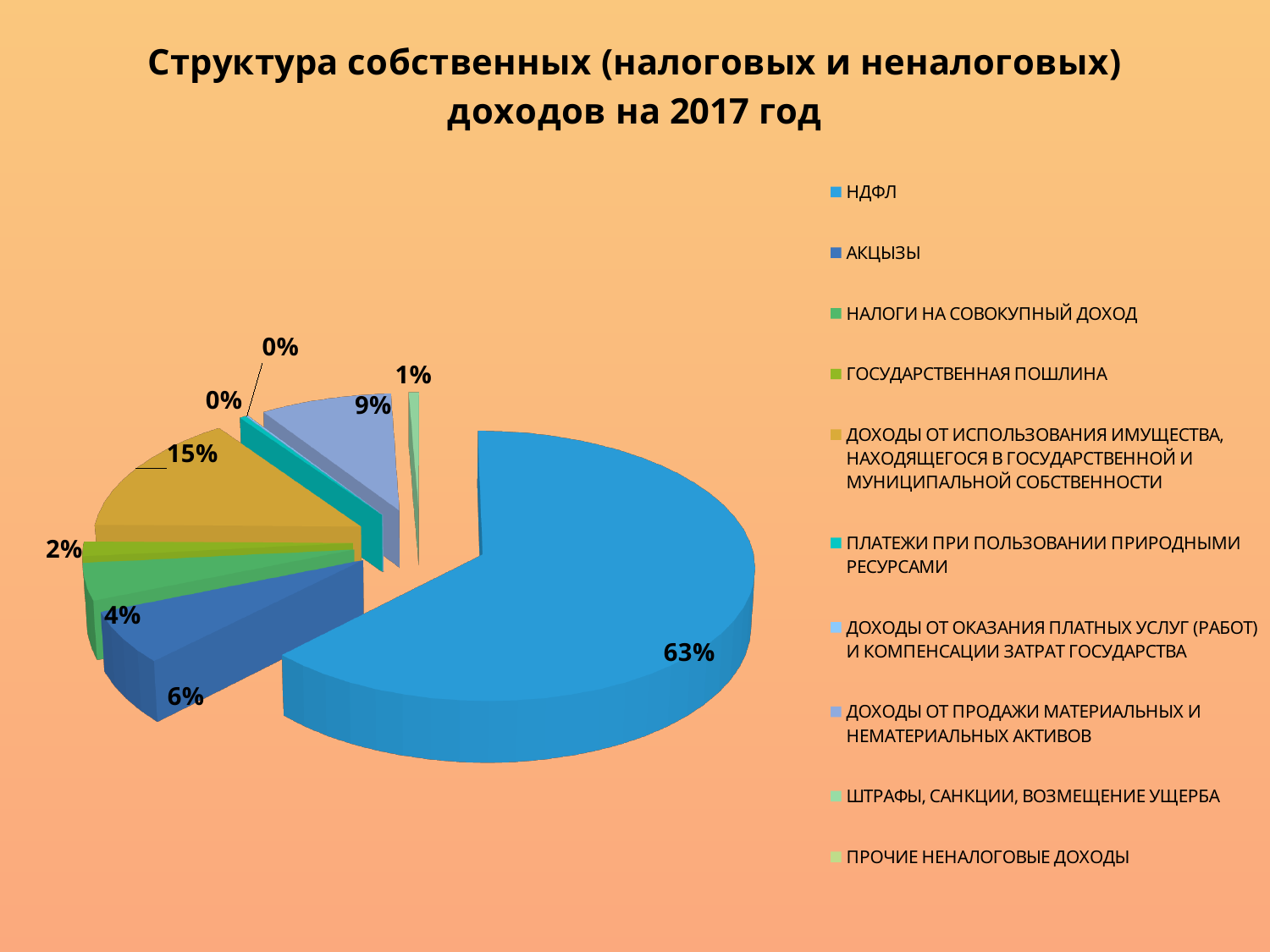
What is the value shown for АКЦИЗЫ? 6% What share of the pie does НДФЛ account for? 63% What is the value shown for ДОХОДЫ ОТ ПРОДАЖИ МАТЕРИАЛЬНЫХ И НЕМАТЕРИАЛЬНЫХ АКТИВОВ? 9% What kind of chart is shown on the slide? Pie chart Which category has the largest share of the pie? НДФЛ What is the title of the chart? Структура собственных (налоговых и неналоговых) доходов на 2017 год How many categories does the legend list? 10 What is the value shown for ГОСУДАРСТВЕННАЯ ПОШЛИНА? 2% Which is larger, the share for АКЦИЗЫ or the share for ДОХОДЫ ОТ ПРОДАЖИ МАТЕРИАЛЬНЫХ И НЕМАТЕРИАЛЬНЫХ АКТИВОВ? ДОХОДЫ ОТ ПРОДАЖИ МАТЕРИАЛЬНЫХ И НЕМАТЕРИАЛЬНЫХ АКТИВОВ What is the value shown for НАЛОГИ НА СОВОКУПНЫЙ ДОХОД? 4% What is the difference in percentage points between НДФЛ and ДОХОДЫ ОТ ИСПОЛЬЗОВАНИЯ ИМУЩЕСТВА? 48 What share is shown for ДОХОДЫ ОТ ИСПОЛЬЗОВАНИЯ ИМУЩЕСТВА, НАХОДЯЩЕГОСЯ В ГОСУДАРСТВЕННОЙ И МУНИЦИПАЛЬНОЙ СОБСТВЕННОСТИ? 15%